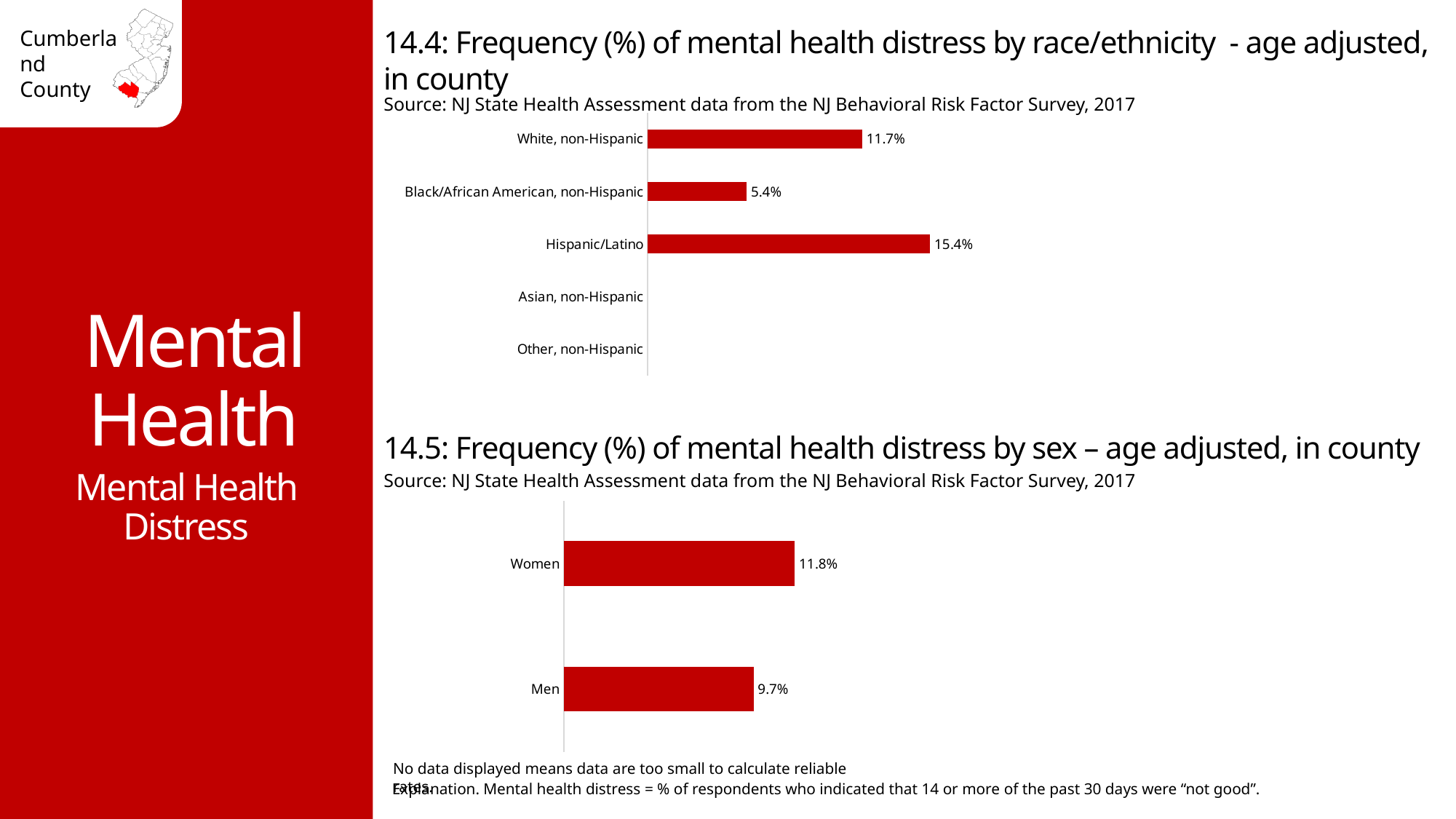
In chart 14.4 (mental health distress by race/ethnicity), what is the value for Black/African American, non-Hispanic? 5.4% What type of chart is chart 14.5 (mental health distress by sex)? Bar chart In chart 14.4 (mental health distress by race/ethnicity), which race/ethnicity group has the highest value? Hispanic/Latino In chart 14.5 (mental health distress by sex), which group has the higher value, Women or Men? Women In chart 14.5 (mental health distress by sex), what is the value for Women? 11.8% In chart 14.5 (mental health distress by sex), what is the value for Men? 9.7% In chart 14.4 (mental health distress by race/ethnicity), what is the value for White, non-Hispanic? 11.7% In chart 14.4 (mental health distress by race/ethnicity), what is the value for Hispanic/Latino? 15.4% In chart 14.4 (mental health distress by race/ethnicity), how many race/ethnicity categories are listed on the axis? 5 In chart 14.4 (mental health distress by race/ethnicity), what is the difference between the Hispanic/Latino and White, non-Hispanic values? 3.7% In chart 14.4 (mental health distress by race/ethnicity), which categories have no bar displayed? Asian, non-Hispanic and Other, non-Hispanic In chart 14.5 (mental health distress by sex), what is the difference between the Women and Men values? 2.1%